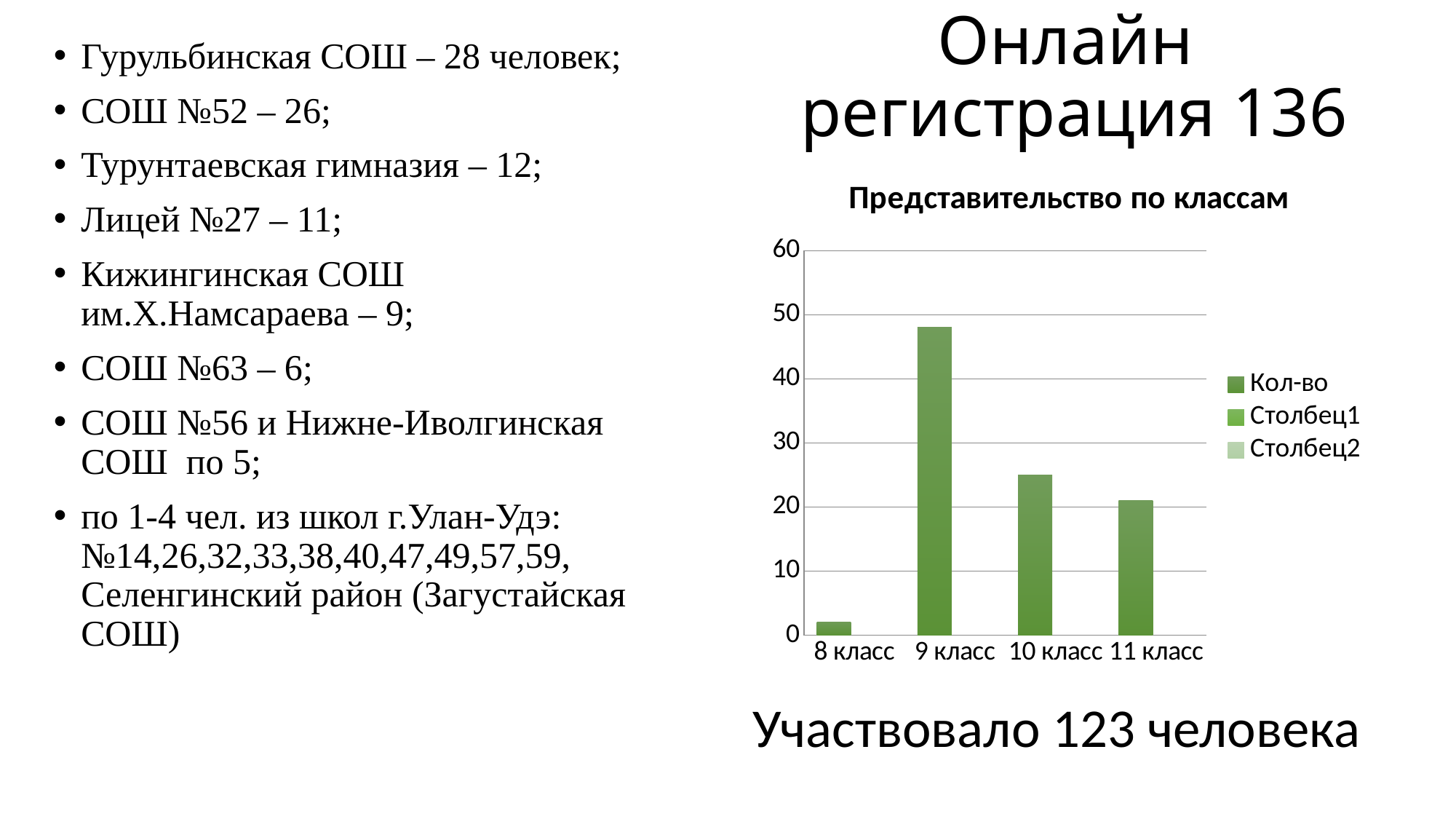
What is the title of the chart on the slide? Представительство по классам Is the value for 8 класс greater or less than 10? less Is the value for 9 класс greater or less than 40? greater Which class has the lowest bar in the chart? 8 класс Is the value for 10 класс greater or less than 30? less How many series does the chart's legend list? 3 What kind of chart is shown under the title "Представительство по классам"? bar chart How many categories (classes) are shown on the x axis of the chart? 4 Which class has the highest bar in the chart? 9 класс Which has a larger value, 10 класс or 11 класс? 10 класс Do the values rise or fall from 9 класс to 11 класс along the x axis? fall Which has a larger value, 8 класс or 11 класс? 11 класс